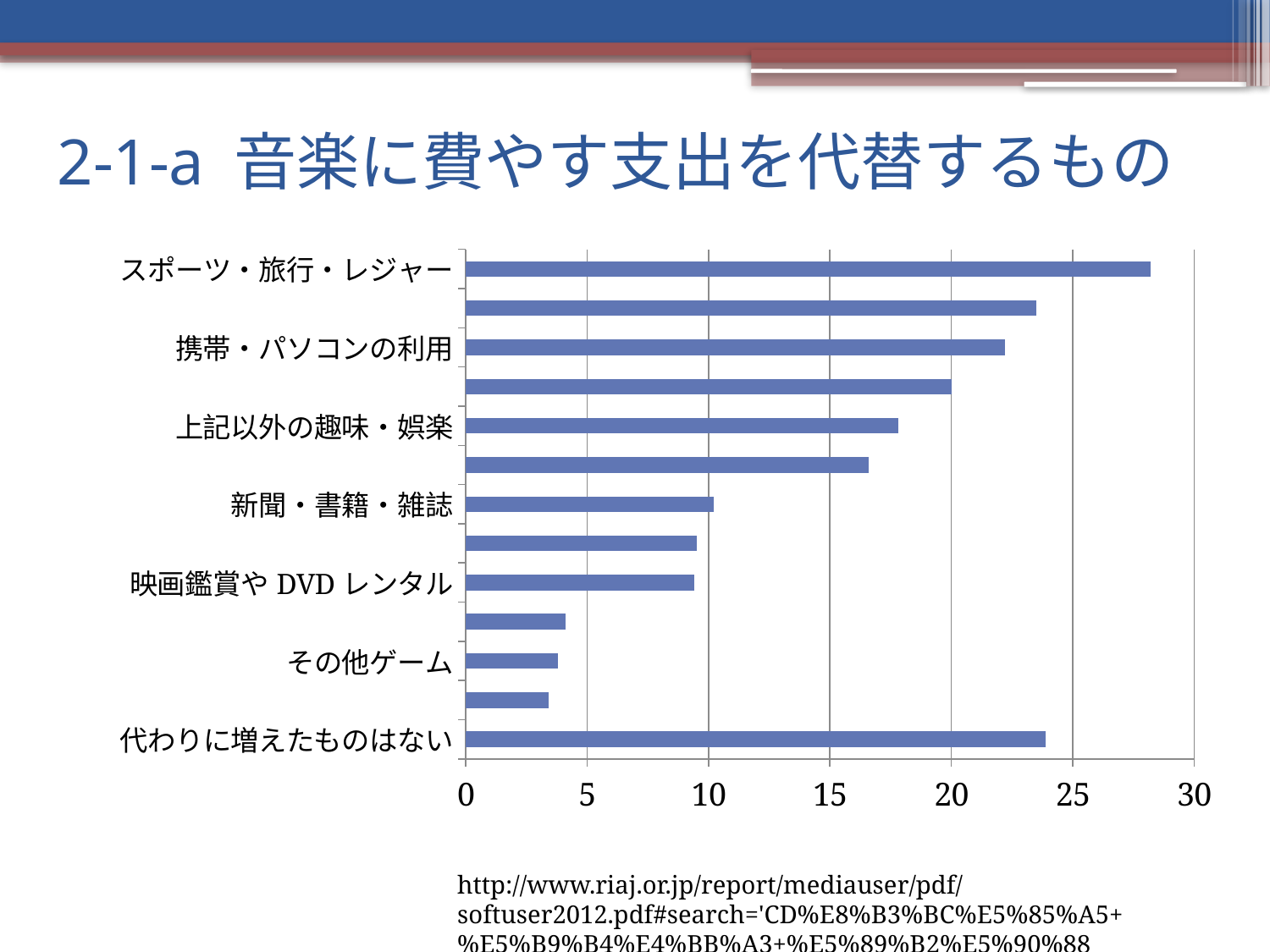
Is the value for その他ゲーム greater or less than 5? less Is the value for 代わりに増えたものはない greater or less than 20? greater What kind of chart is shown on the slide? bar chart Which is larger, the value for 代わりに増えたものはない or the value for 上記以外の趣味・娯楽? 代わりに増えたものはない Is the value for 携帯・パソコンの利用 greater or less than 20? greater How many bars are plotted in the chart? 13 Which category has the longest bar in the chart? スポーツ・旅行・レジャー Which is larger, the value for 新聞・書籍・雑誌 or the value for その他ゲーム? 新聞・書籍・雑誌 What is the title of the slide containing the chart? 2-1-a 音楽に費やす支出を代替するもの